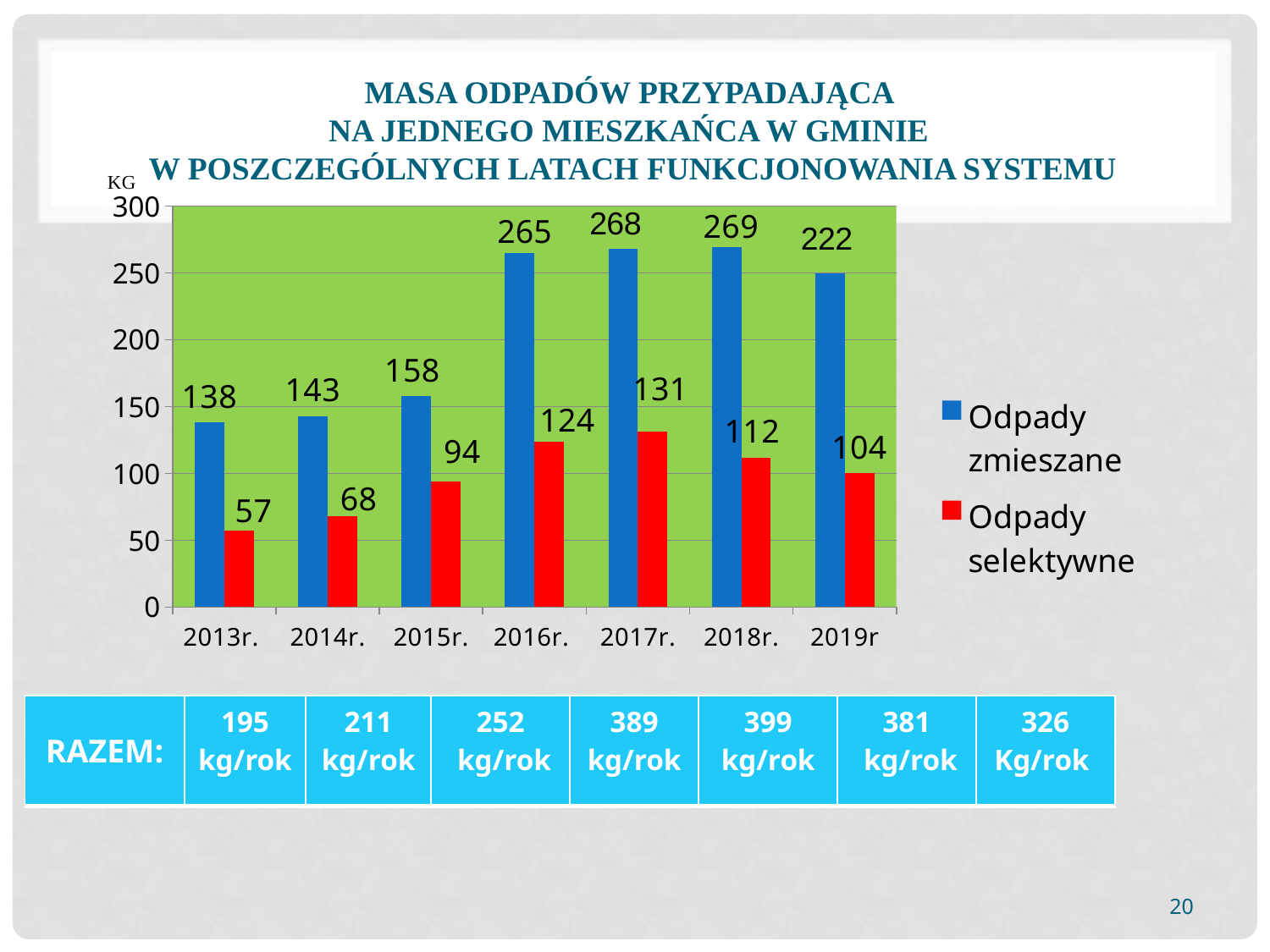
Do the values for Odpady selektywne rise or fall from 2013r. to 2017r.? rise What is the value for Odpady zmieszane in 2016r.? 265 In which year is the value for Odpady zmieszane the highest? 2018r. What type of chart is shown on the slide? bar chart Which is larger: Odpady selektywne in 2016r. or Odpady selektywne in 2018r.? Odpady selektywne in 2016r. In which year is the value for Odpady selektywne the lowest? 2013r. What is the difference between Odpady zmieszane and Odpady selektywne in 2015r.? 64 How many series does the legend list? 2 How many years are shown on the x axis of the chart? 7 What is the value for Odpady selektywne in 2017r.? 131 What is the value for Odpady selektywne in 2014r.? 68 Which colour represents Odpady zmieszane in the chart? blue